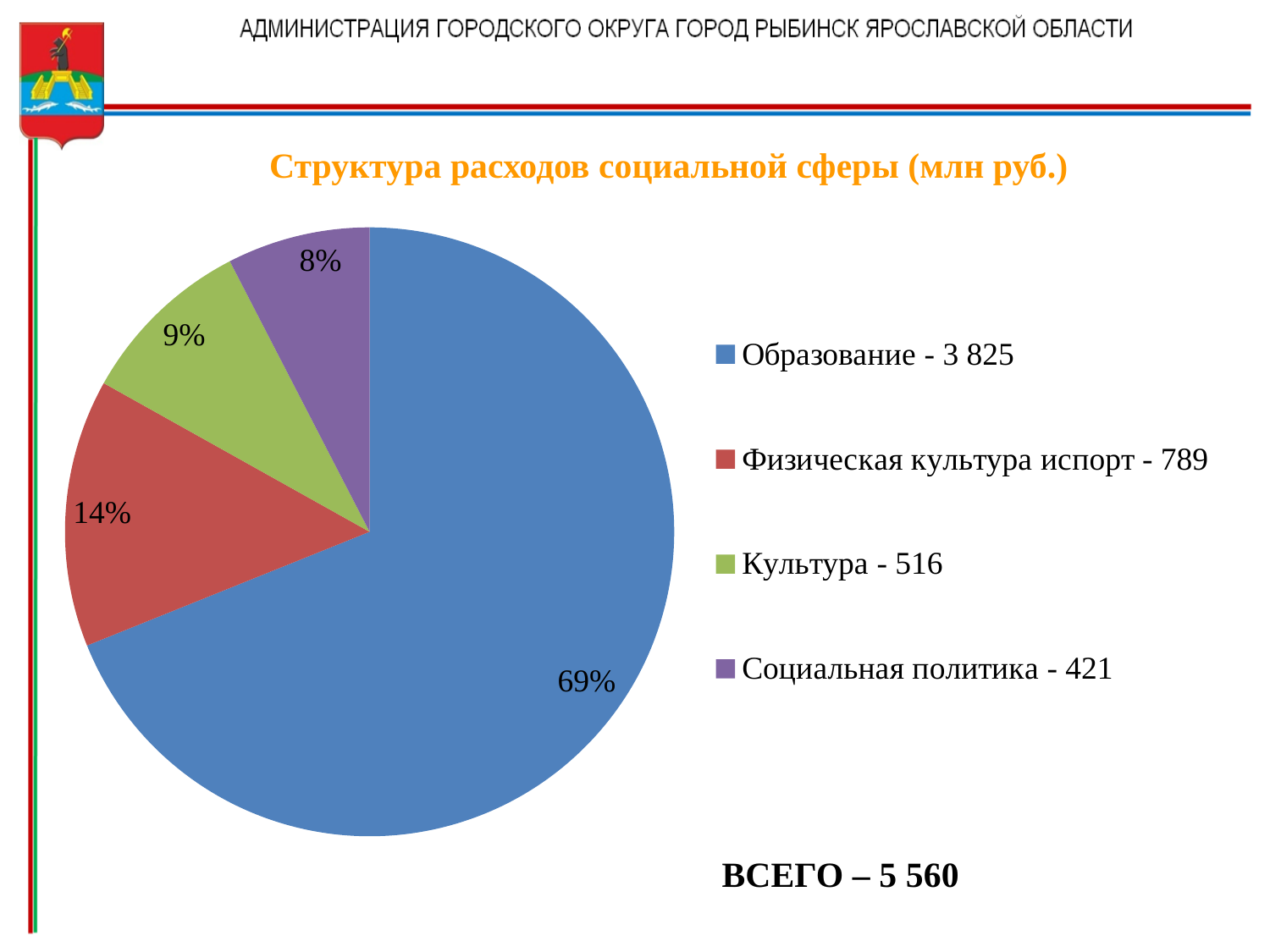
What value is given for Социальная политика in the legend? 421 Which category has the smallest share of the pie? Социальная политика How many slices does the pie chart have? 4 What value is given for Образование in the legend? 3 825 What is the title of the chart? Структура расходов социальной сферы (млн руб.) What kind of chart is shown on the slide? pie chart What share of the pie does Социальная политика take? 8% Which category has the largest share of the pie? Образование What share of the pie does Культура take? 9% What share of the pie does Физическая культура и спорт take? 14% What is the difference between the values for Физическая культура и спорт and Культура? 273